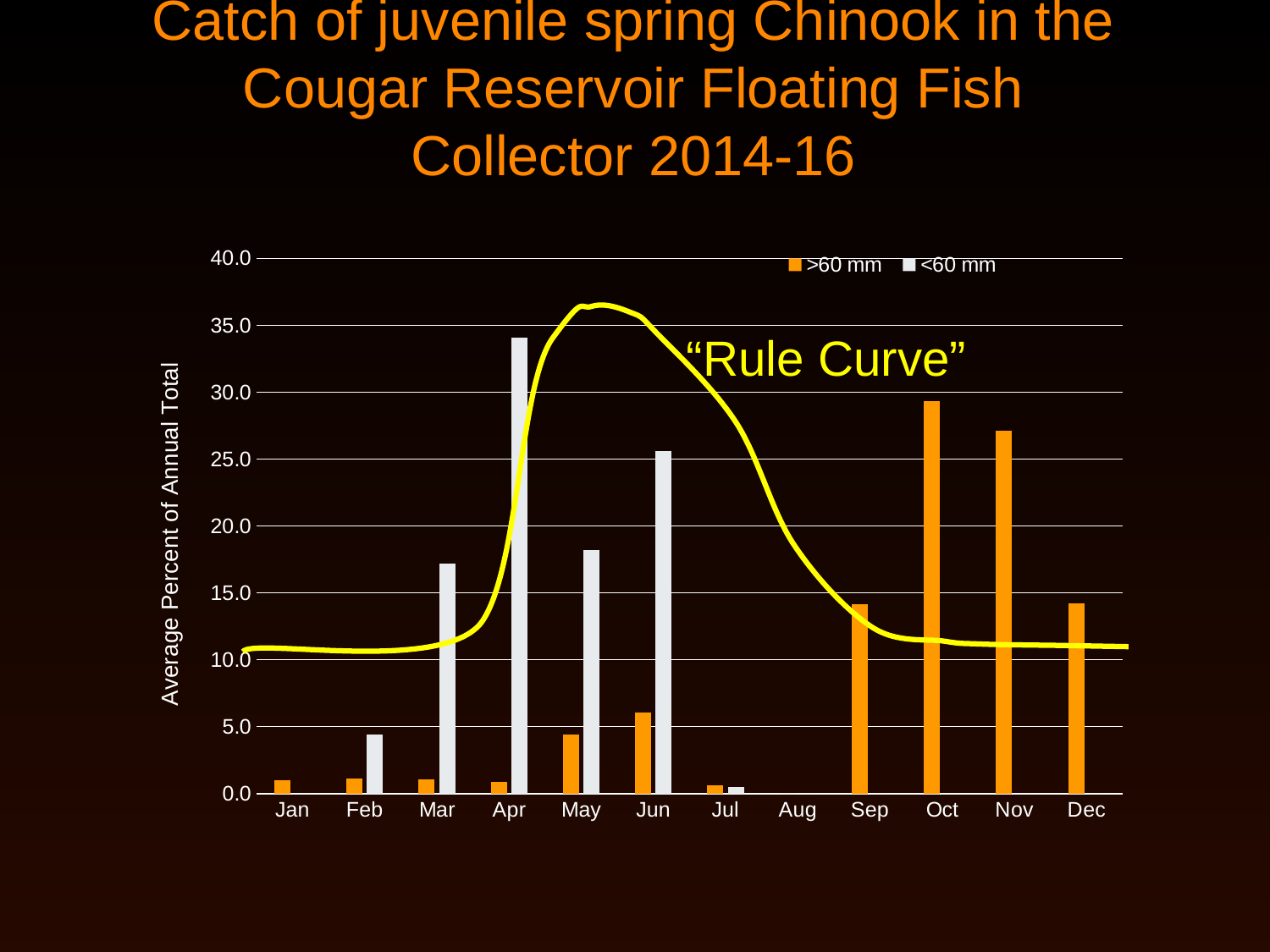
In which month is the >60 mm bar highest? Oct How many months are shown along the x axis? 12 Is the >60 mm value for Oct greater or less than 25.0? greater What is the label on the y axis? Average Percent of Annual Total Which is larger, the >60 mm value for Oct or for Nov? Oct Is the <60 mm value for Mar greater or less than 15.0? greater What kind of chart is shown on the slide? Bar chart Is the <60 mm value for Apr greater or less than 30.0? greater Which is larger, the <60 mm value for Apr or for Jun? Apr How many series does the legend list? 2 In which month is the <60 mm bar highest? Apr